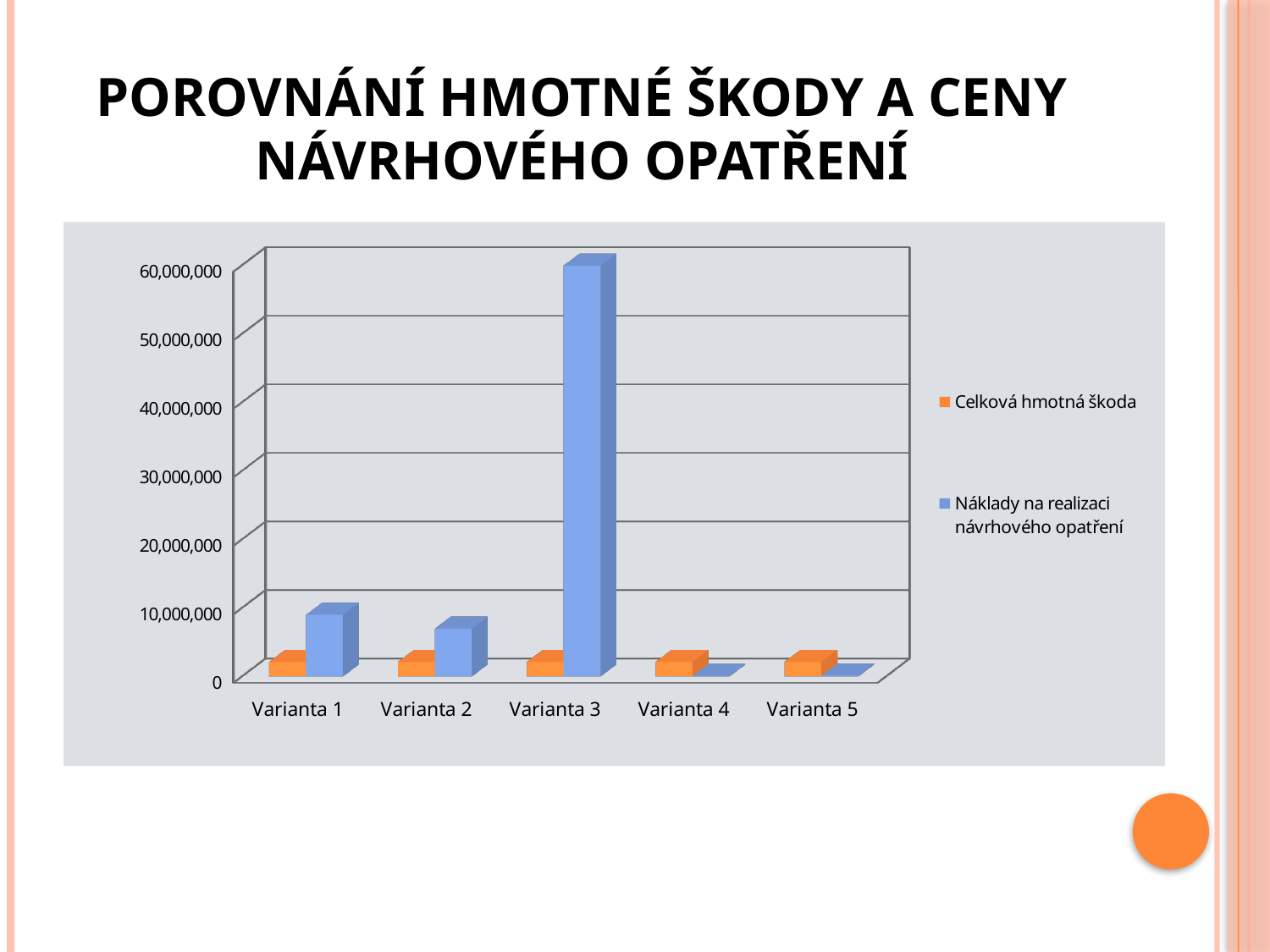
Which has the larger value for Náklady na realizaci návrhového opatření: Varianta 1 or Varianta 2? Varianta 1 Is the value of Náklady na realizaci návrhového opatření for Varianta 1 greater or less than 20,000,000? less What is the title of the slide containing the chart? Porovnání hmotné škody a ceny návrhového opatření Which series is shown in orange? Celková hmotná škoda How many categories (variants) are shown on the x axis? 5 What kind of chart is shown on the slide? bar chart Is the value of Náklady na realizaci návrhového opatření for Varianta 2 greater or less than 10,000,000? less Is the value of Celková hmotná škoda for Varianta 1 greater or less than 10,000,000? less How many series does the legend list? 2 Which is larger for Varianta 3: Celková hmotná škoda or Náklady na realizaci návrhového opatření? Náklady na realizaci návrhového opatření Which variant has the highest value for Náklady na realizaci návrhového opatření? Varianta 3